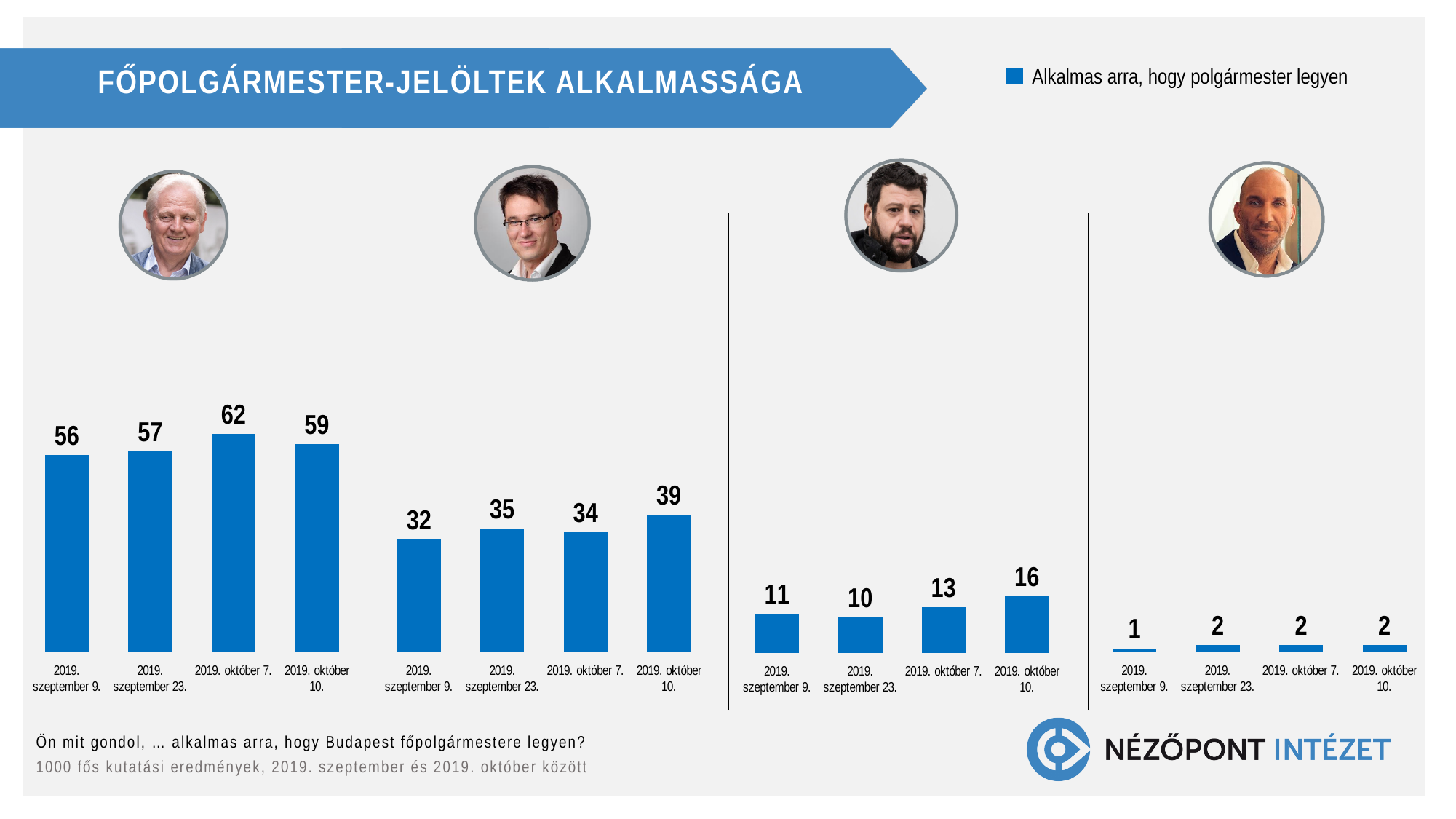
In the third chart from the left, which date has the lowest value? 2019. szeptember 23. In the second chart from the left, what is the difference between the values for 2019. október 10. and 2019. szeptember 9.? 7 What does the legend entry at the top right of the slide say? Alkalmas arra, hogy polgármester legyen In the third chart from the left, what is the value for 2019. szeptember 23.? 10 In the rightmost chart, what is the value for 2019. szeptember 9.? 1 In the leftmost chart, what is the value for 2019. október 7.? 62 In the leftmost chart, which is larger: the value for 2019. szeptember 9. or the value for 2019. október 10.? 2019. október 10. In the third chart from the left, do the values rise or fall from 2019. szeptember 23. to 2019. október 10.? rise In the second chart from the left, what is the value for 2019. október 10.? 39 What kind of chart is the leftmost chart? bar chart How many bars does the third chart from the left have? 4 In the leftmost chart, which date has the highest value? 2019. október 7.